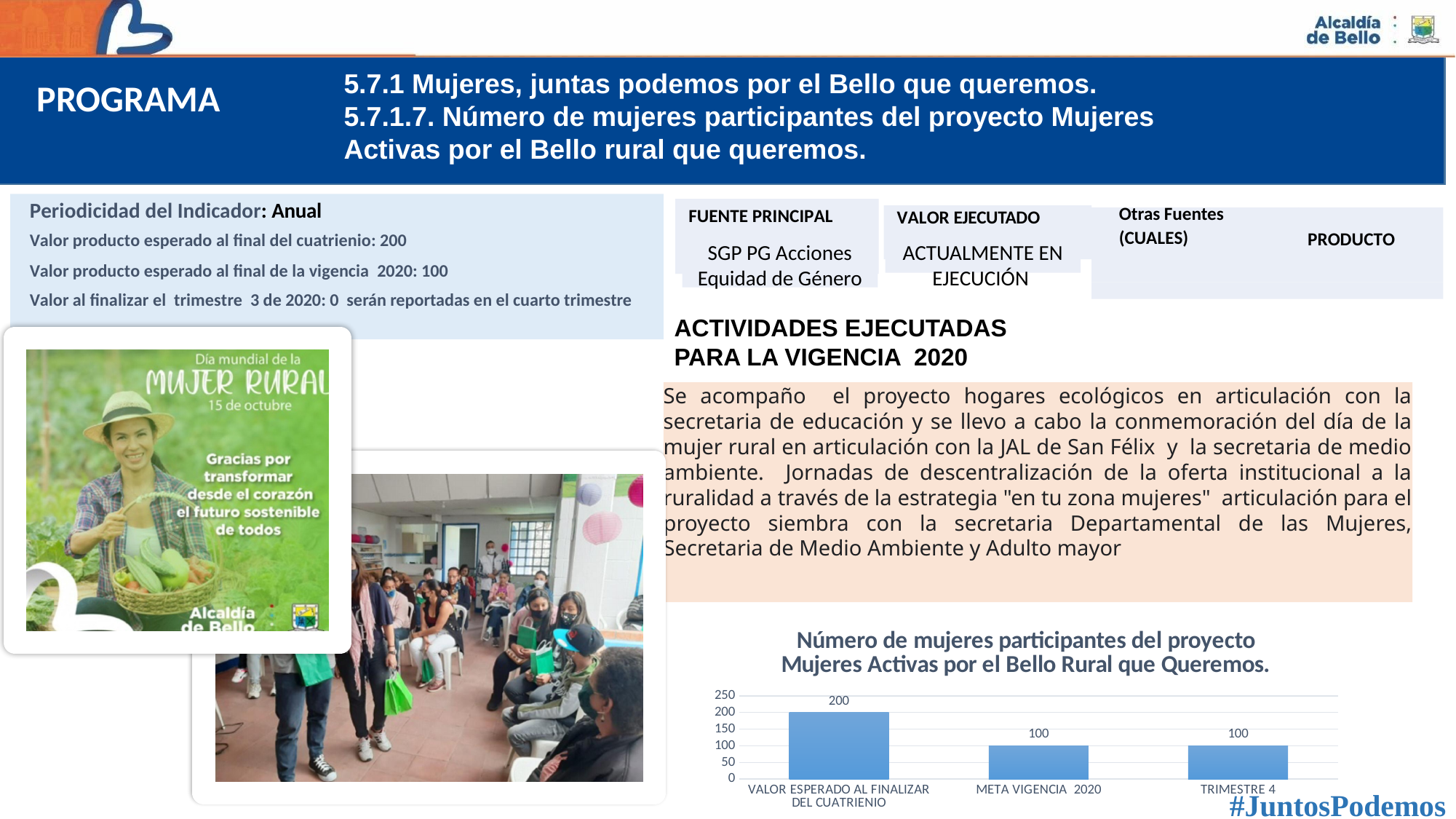
Which is larger, VALOR ESPERADO AL FINALIZAR DEL CUATRIENIO or TRIMESTRE 4? VALOR ESPERADO AL FINALIZAR DEL CUATRIENIO Is the value for VALOR ESPERADO AL FINALIZAR DEL CUATRIENIO greater or less than 150? greater What kind of chart is shown? bar chart Which category has the highest value? VALOR ESPERADO AL FINALIZAR DEL CUATRIENIO What is the maximum value shown on the vertical axis? 250 What is the value for META VIGENCIA 2020? 100 What is the title of the chart? Número de mujeres participantes del proyecto Mujeres Activas por el Bello Rural que Queremos. Is the value for META VIGENCIA 2020 greater or less than 150? less What is the value for TRIMESTRE 4? 100 What is the value for VALOR ESPERADO AL FINALIZAR DEL CUATRIENIO? 200 What is the difference between VALOR ESPERADO AL FINALIZAR DEL CUATRIENIO and META VIGENCIA 2020? 100 How many categories are shown in the chart? 3